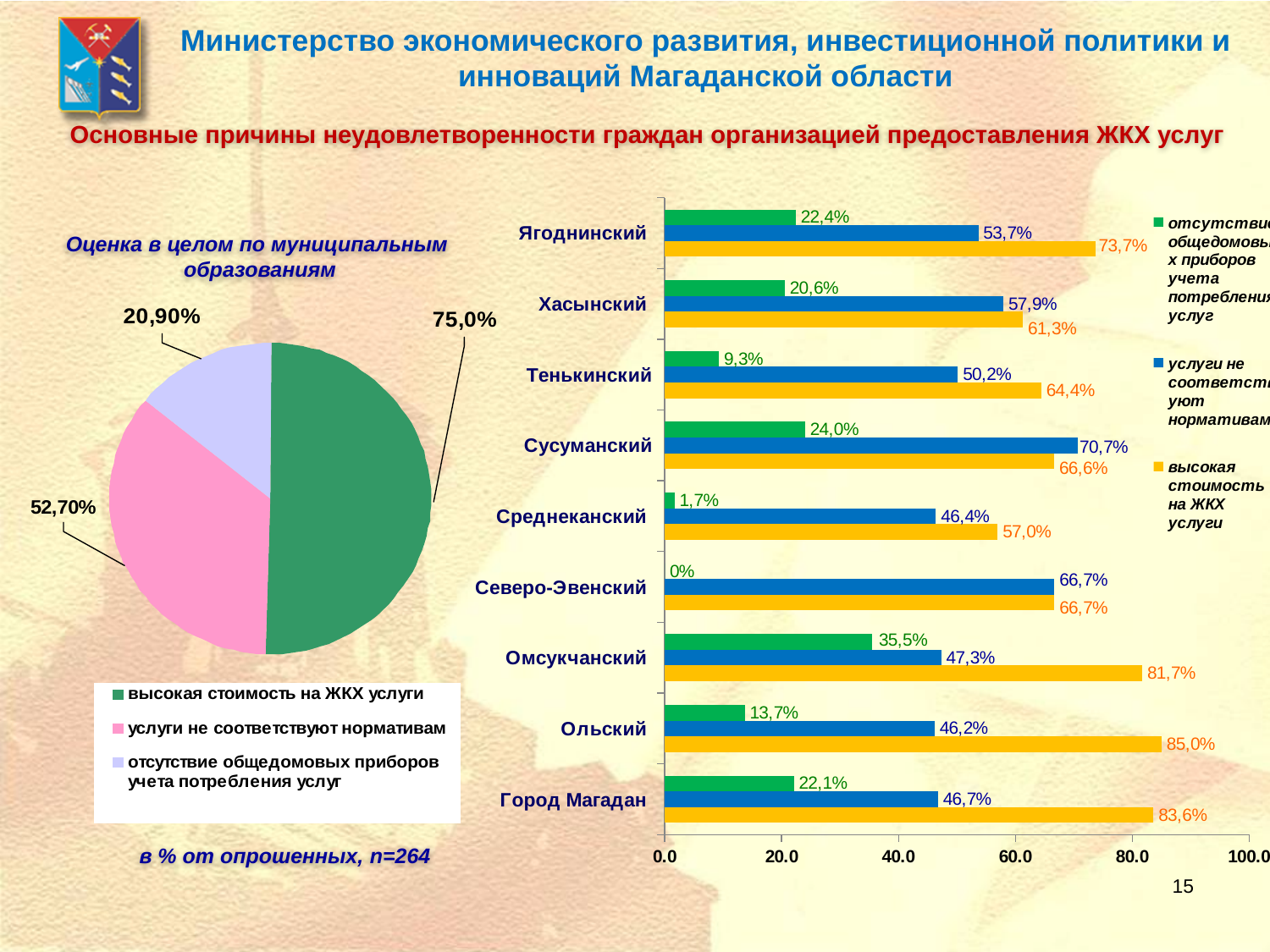
In the bar chart on the right, what is the value of the green series (отсутствие общедомовых приборов учета) for Омсукчанский? 35,5% In the bar chart on the right, what is the value of the blue series (услуги не соответствуют нормативам) for Сусуманский? 70,7% How many municipalities are shown in the bar chart on the right? 9 In the pie chart on the left, which category has the largest value? высокая стоимость на ЖКХ услуги In the bar chart on the right, which municipality has the highest value for the yellow series (высокая стоимость на ЖКХ услуги)? Ольский In the pie chart on the left, what is the value for 'услуги не соответствуют нормативам'? 52,70% How many series does the legend of the bar chart on the right list? 3 In the bar chart on the right, which municipality has the lowest value for the green series (отсутствие общедомовых приборов учета)? Северо-Эвенский What type of chart is the chart on the left titled 'Оценка в целом по муниципальным образованиям'? pie chart In the bar chart on the right, what is the difference between the yellow series values for Ольский and Ягоднинский? 11,3% In the bar chart on the right, what is the value of the yellow series (высокая стоимость на ЖКХ услуги) for Ольский? 85,0% In the bar chart on the right, which is larger for Сусуманский: the blue series value or the yellow series value? the blue series (70,7%)